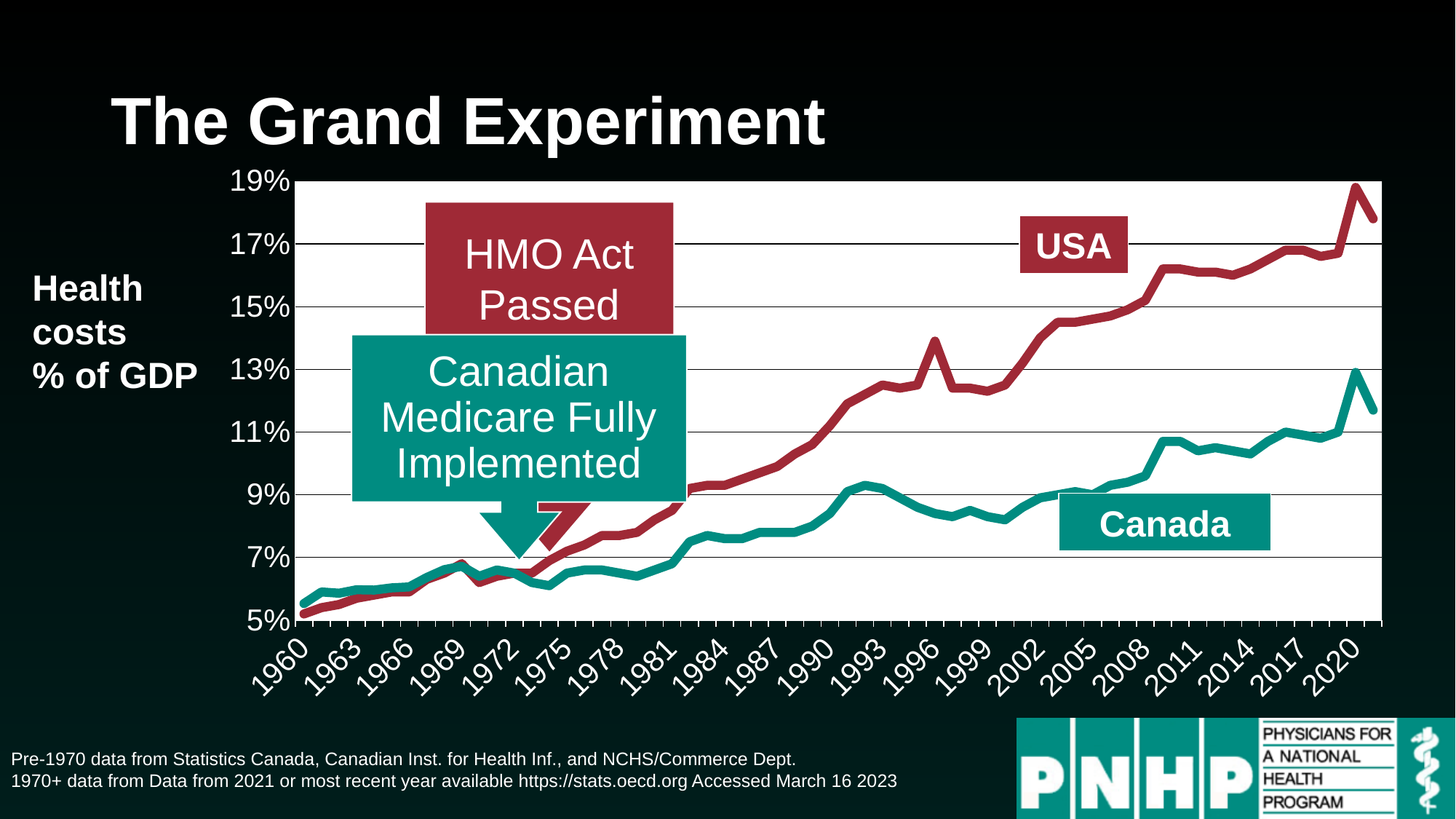
What is the title of the slide containing the chart? The Grand Experiment Is the Canada value around 1984 greater or less than 7%? greater Do the USA health costs as a share of GDP generally rise or fall from 1960 to 2020? rise Which series reaches the highest value on the chart? USA What does the y-axis of the chart measure, according to the label on the left? Health costs % of GDP Is the USA value in 1960 greater or less than 7%? less How many series (countries) are plotted on the chart? 2 What kind of chart is shown on the slide? Line chart Which series has the larger value around 1990, USA or Canada? USA Is the USA value around 2020 greater or less than 17%? greater